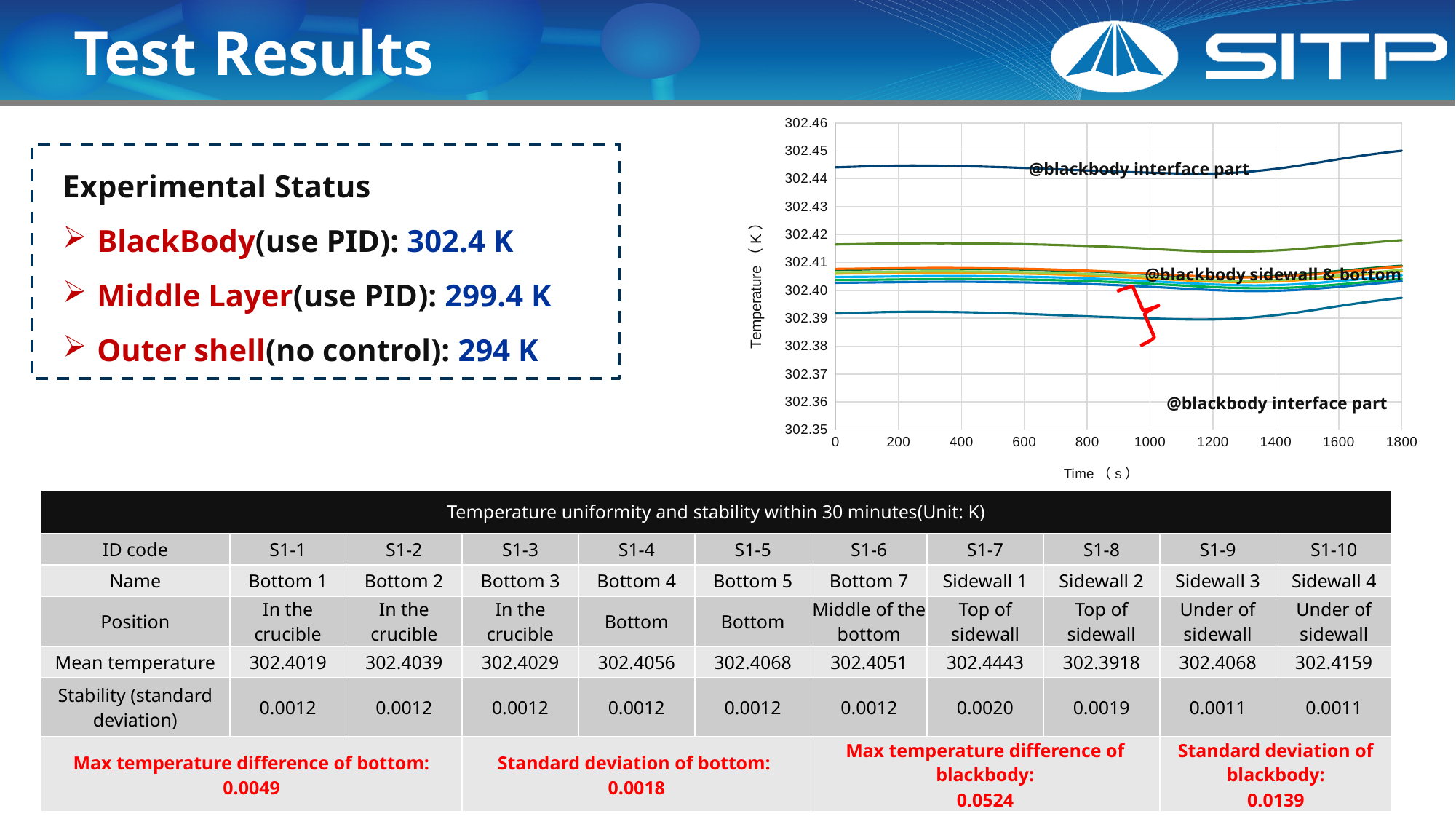
Is the value of the topmost line at 1800 s greater or less than 302.44? greater Does the topmost line rise or fall between 1200 s and 1800 s? rise What is the label of the y axis of the chart? Temperature (K) What is the largest time value shown on the x axis of the chart? 1800 What is the label of the x axis of the chart? Time (s) Is the value of the lowest line at 1200 s greater or less than 302.40? less What kind of chart is shown on the slide? line chart What is the highest tick value shown on the y axis of the chart? 302.46 Does the lowest line rise or fall between 1200 s and 1800 s? rise Which annotated group of lines lies in the middle of the chart, between the top and bottom lines? @blackbody sidewall & bottom Is the value of the lowest line at 0 s greater or less than 302.38? greater What is the lowest tick value shown on the y axis of the chart? 302.35